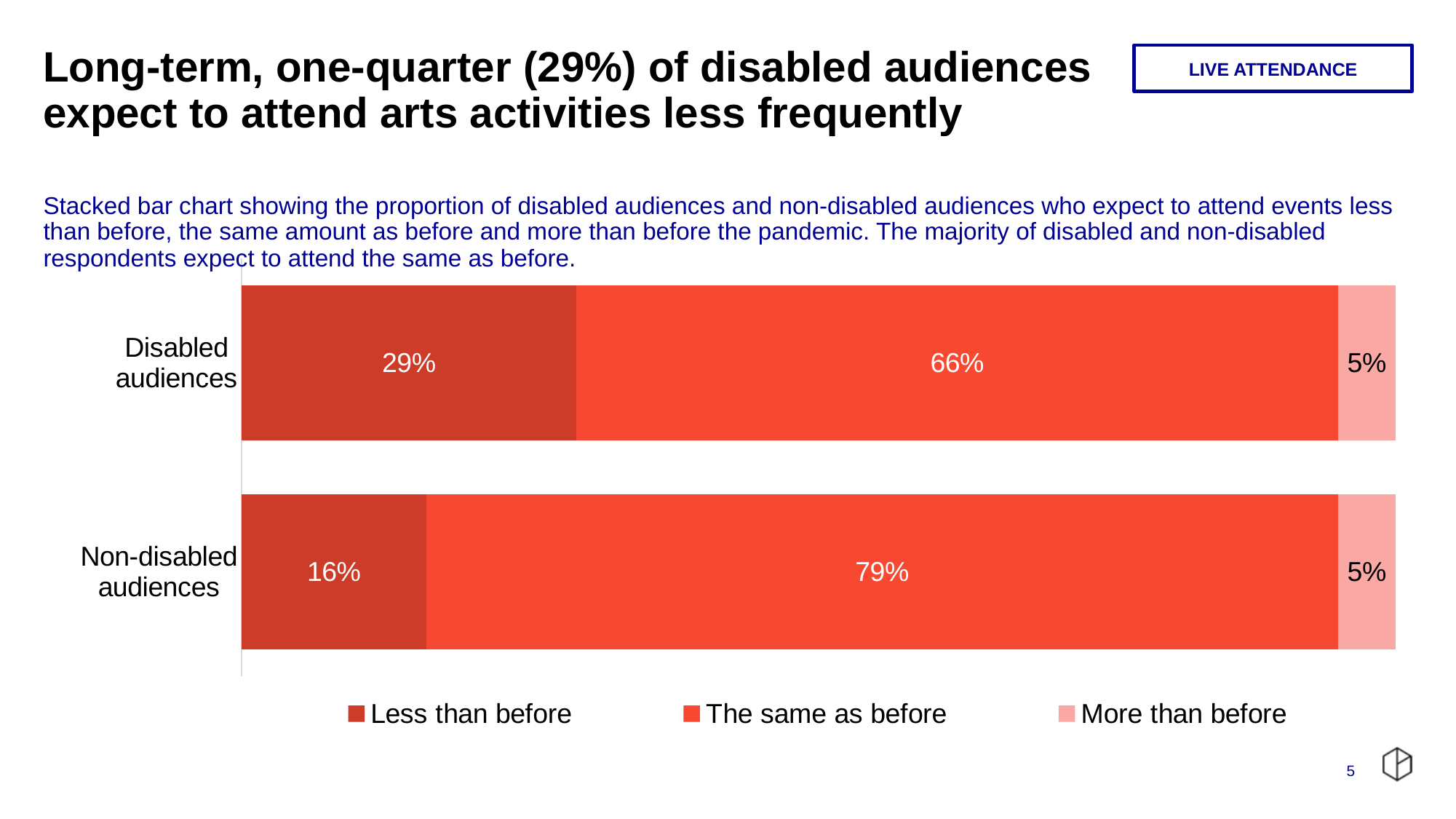
How many series does the legend list? 3 Which response category is the largest for disabled audiences? The same as before What percentage of non-disabled audiences expect to attend less than before? 16% What percentage of disabled audiences expect to attend more than before? 5% What percentage of non-disabled audiences expect to attend the same as before? 79% How many audience groups are shown in the chart? 2 Which audience group has the higher share expecting to attend the same as before? Non-disabled audiences Which response category is the smallest for non-disabled audiences? More than before What is the difference between the 'Less than before' shares for disabled and non-disabled audiences? 13% What is the difference between the 'The same as before' shares for non-disabled and disabled audiences? 13% What percentage of disabled audiences expect to attend less than before? 29% What kind of chart is shown on the slide? Stacked bar chart